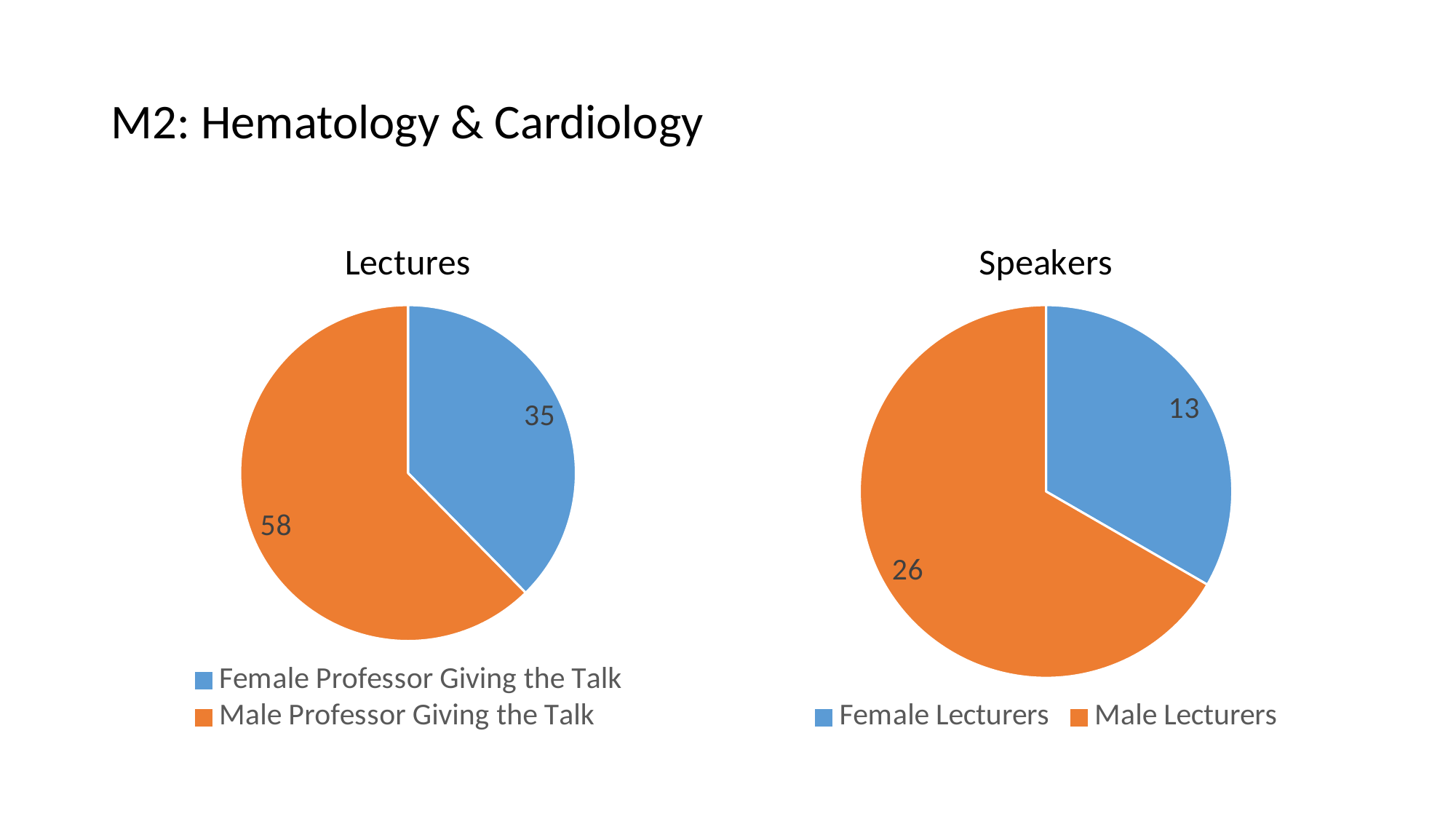
In the Lectures chart, what colour is the Female Professor Giving the Talk slice? Blue How many slices does the Speakers chart have? 2 In the Speakers chart, which category has the smallest slice? Female Lecturers In the Lectures chart, what is the value for Female Professor Giving the Talk? 35 In the Speakers chart, what is the value for Female Lecturers? 13 In the Speakers chart, what is the difference between Male Lecturers and Female Lecturers? 13 In the Lectures chart, what is the value for Male Professor Giving the Talk? 58 In the Lectures chart, what is the difference between the Male Professor Giving the Talk and Female Professor Giving the Talk values? 23 In the Speakers chart, which is larger, Female Lecturers or Male Lecturers? Male Lecturers In the Speakers chart, what is the value for Male Lecturers? 26 In the Lectures chart, which category has the largest slice? Male Professor Giving the Talk What type of chart is the Lectures chart? Pie chart